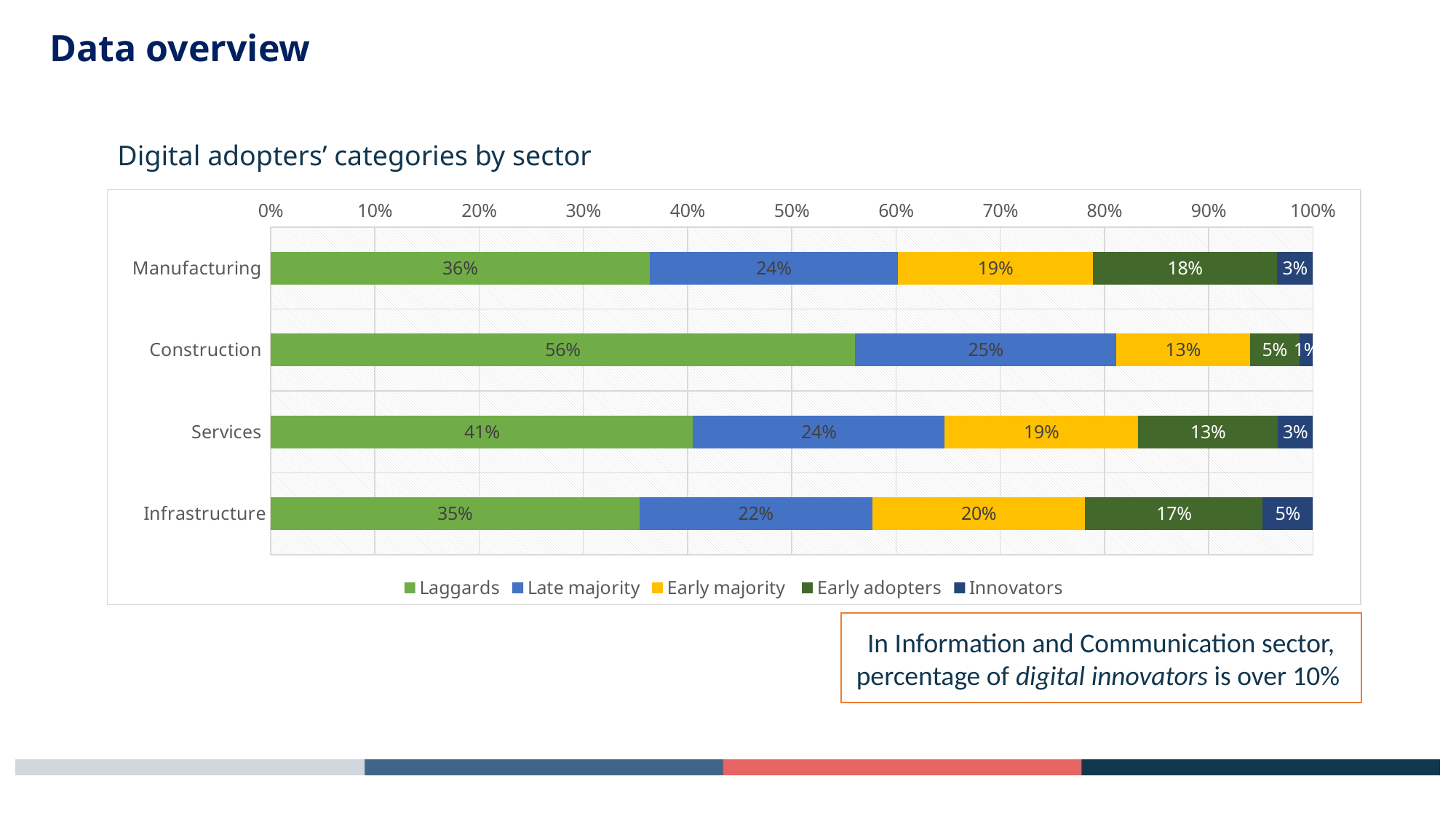
How many sectors are shown on the chart? 4 How many series does the legend list? 5 What is the Early adopters share for Manufacturing? 18% What is the Innovators share for Infrastructure? 5% What kind of chart is shown? Stacked bar chart What is the difference between the Laggards shares of Construction and Manufacturing? 20% Which sector has the highest Laggards share? Construction What is the Laggards share for Construction? 56% Which sector has the lowest Innovators share? Construction What is the Late majority share for Services? 24% Which is larger, the Early adopters share for Infrastructure or for Services? Infrastructure What is the title of the chart? Digital adopters' categories by sector